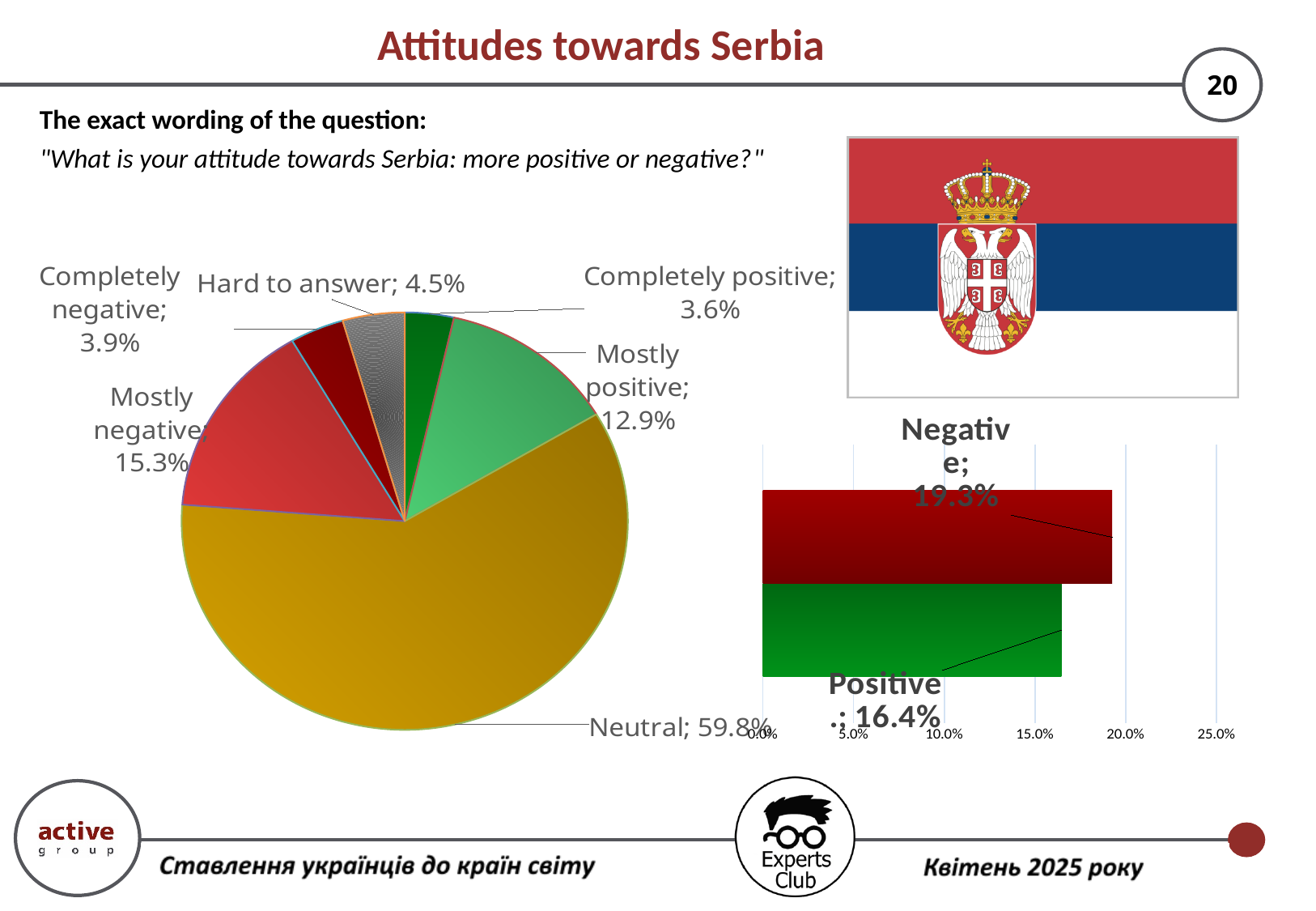
How many categories does the pie chart on the left show? 6 In the pie chart, what is the value for "Hard to answer"? 4.5% In the pie chart, what is the value for "Mostly negative"? 15.3% In the pie chart, which is larger: "Completely negative" or "Completely positive"? Completely negative In the pie chart, which category has the largest slice? Neutral In the bar chart on the right, what is the value for "Positive"? 16.4% In the pie chart, what is the value for "Mostly positive"? 12.9% In the bar chart on the right, what is the value for "Negative"? 19.3% In the pie chart, which category has the smallest slice? Completely positive In the pie chart, what share of respondents answered "Neutral"? 59.8% In the pie chart, what is the difference between "Mostly negative" and "Mostly positive"? 2.4% What type of chart is shown on the right side of the slide? Bar chart